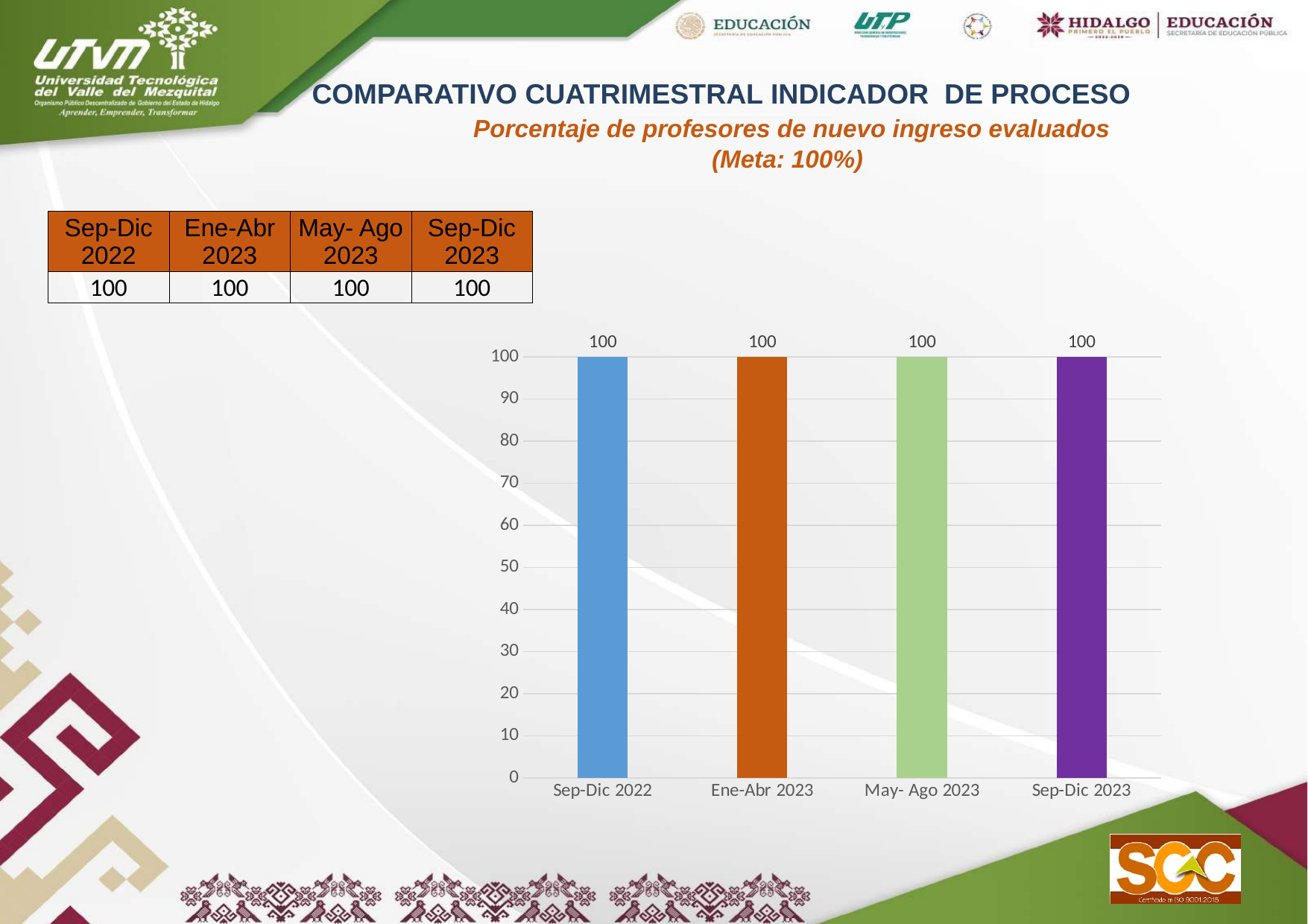
Is the value for May- Ago 2023 greater or less than 90? greater What is the value for Sep-Dic 2022? 100 What is the value for Ene-Abr 2023? 100 What is the value for May- Ago 2023? 100 What is the value for Sep-Dic 2023? 100 What colour is the bar for Ene-Abr 2023? orange What is the total of the four values shown in the chart? 400 What kind of chart is shown on the slide? bar chart What target (Meta) is stated in the slide subtitle? 100% What is the difference between the values for Sep-Dic 2023 and Sep-Dic 2022? 0 How many categories are shown on the x axis of the chart? 4 Do the values rise, fall, or stay the same from Sep-Dic 2022 to Sep-Dic 2023? stay the same